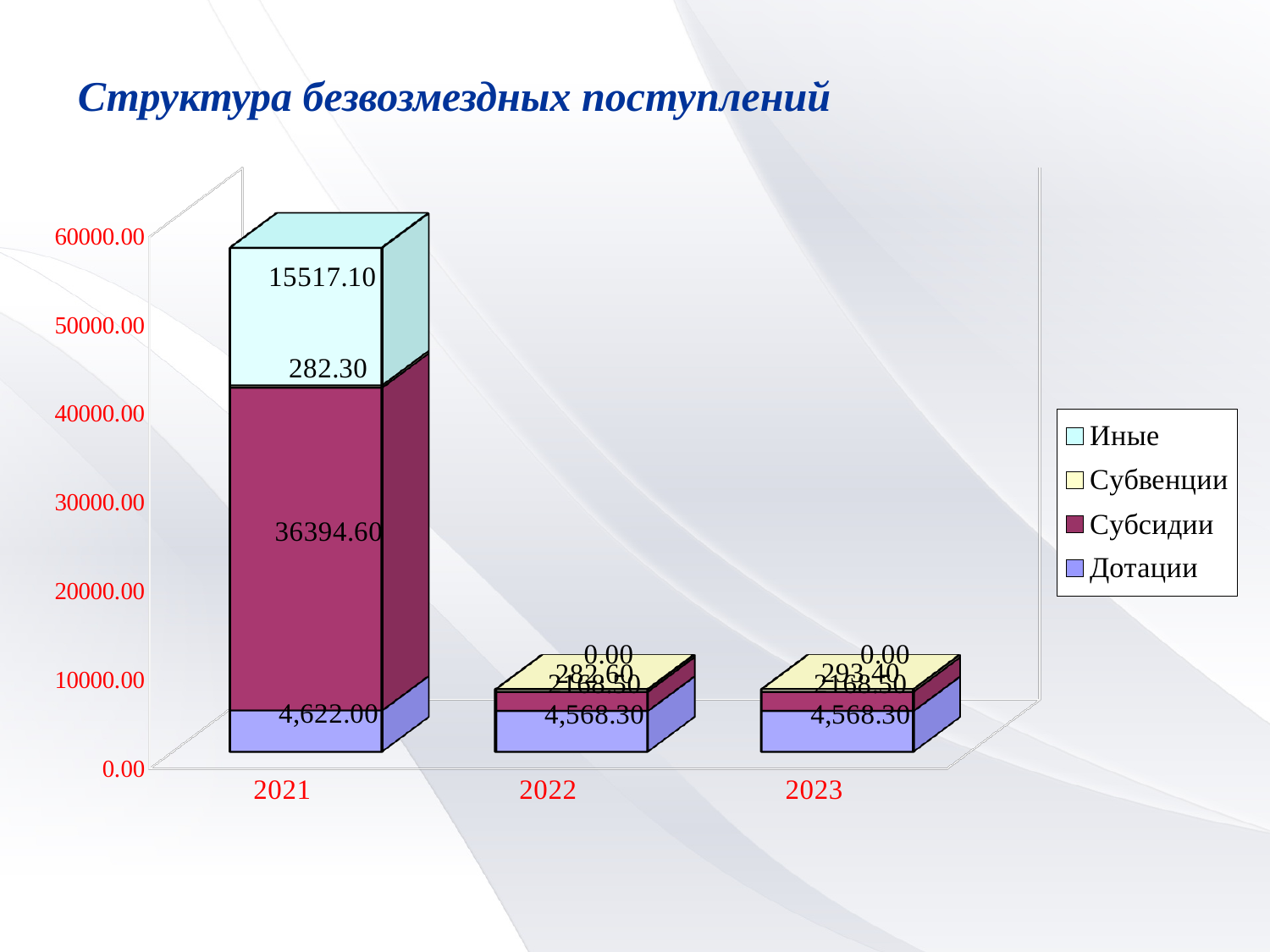
What is the value of Иные for 2022? 0.00 What is the value of Субвенции for 2023? 293.40 What is the title of the chart? Структура безвозмездных поступлений What is the value of Дотации for 2022? 4,568.30 How many series does the legend list? 4 What is the difference between Субсидии and Дотации in 2021? 31772.60 What kind of chart is shown on the slide? Stacked bar chart In 2021, which is larger: Субсидии or Дотации? Субсидии What is the value of Иные for 2021? 15517.10 Which year has the tallest stacked bar? 2021 How many years are shown on the x axis? 3 What is the value of Субсидии for 2021? 36394.60